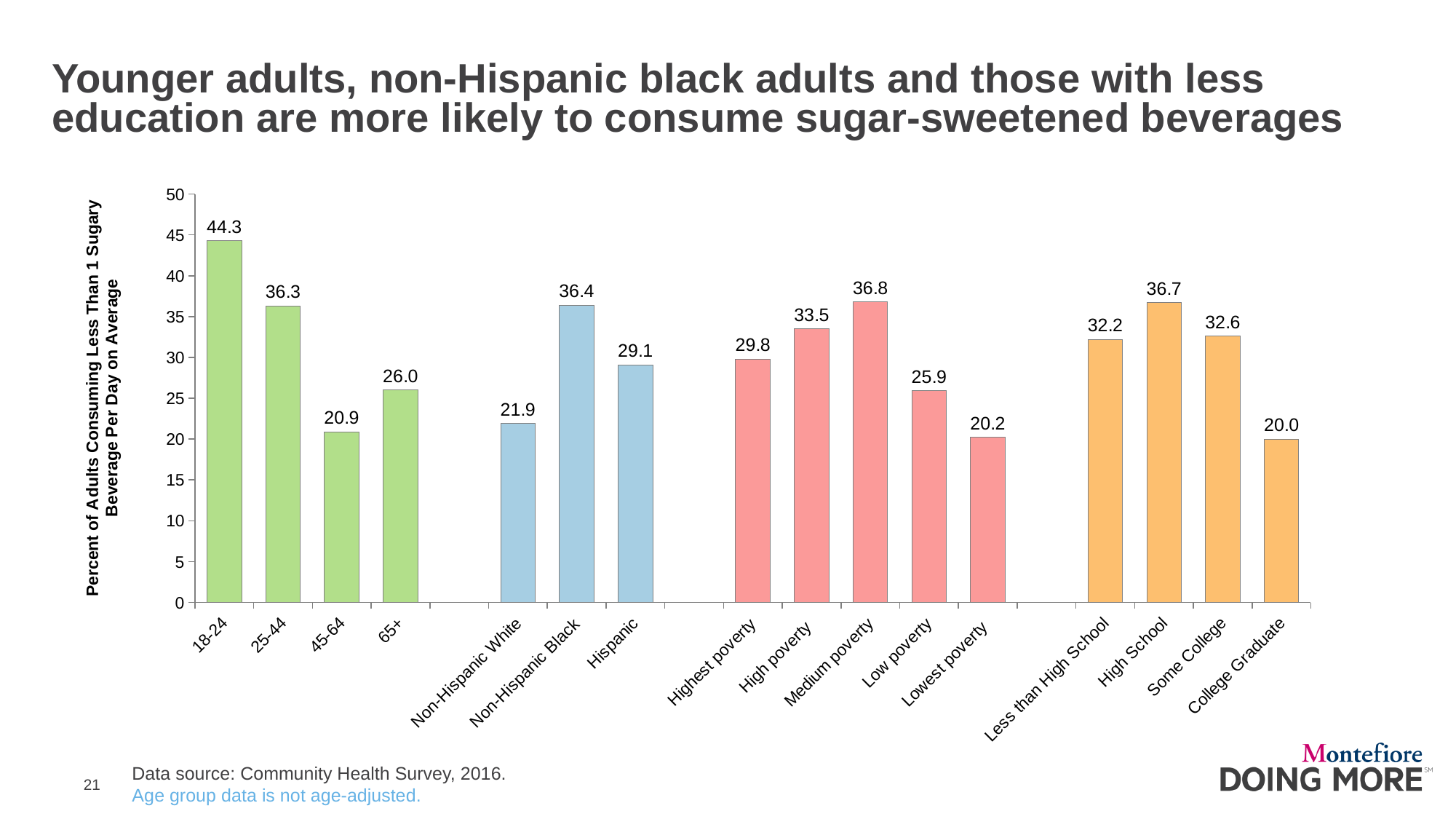
What is the value for the 18-24 age group? 44.3 What is the label of the vertical axis? Percent of Adults Consuming Less Than 1 Sugary Beverage Per Day on Average Which is larger, the value for High School or the value for Some College? High School What is the difference between the values for 18-24 and 65+? 18.3 How many categories are plotted on the chart? 16 What is the difference between the values for Non-Hispanic Black and Non-Hispanic White? 14.5 What is the value for Non-Hispanic Black adults? 36.4 What kind of chart is shown on the slide? Bar chart What is the value for the Lowest poverty category? 20.2 What is the value for College Graduate? 20.0 Which category has the lowest value on the chart? College Graduate Which category has the highest value on the chart? 18-24